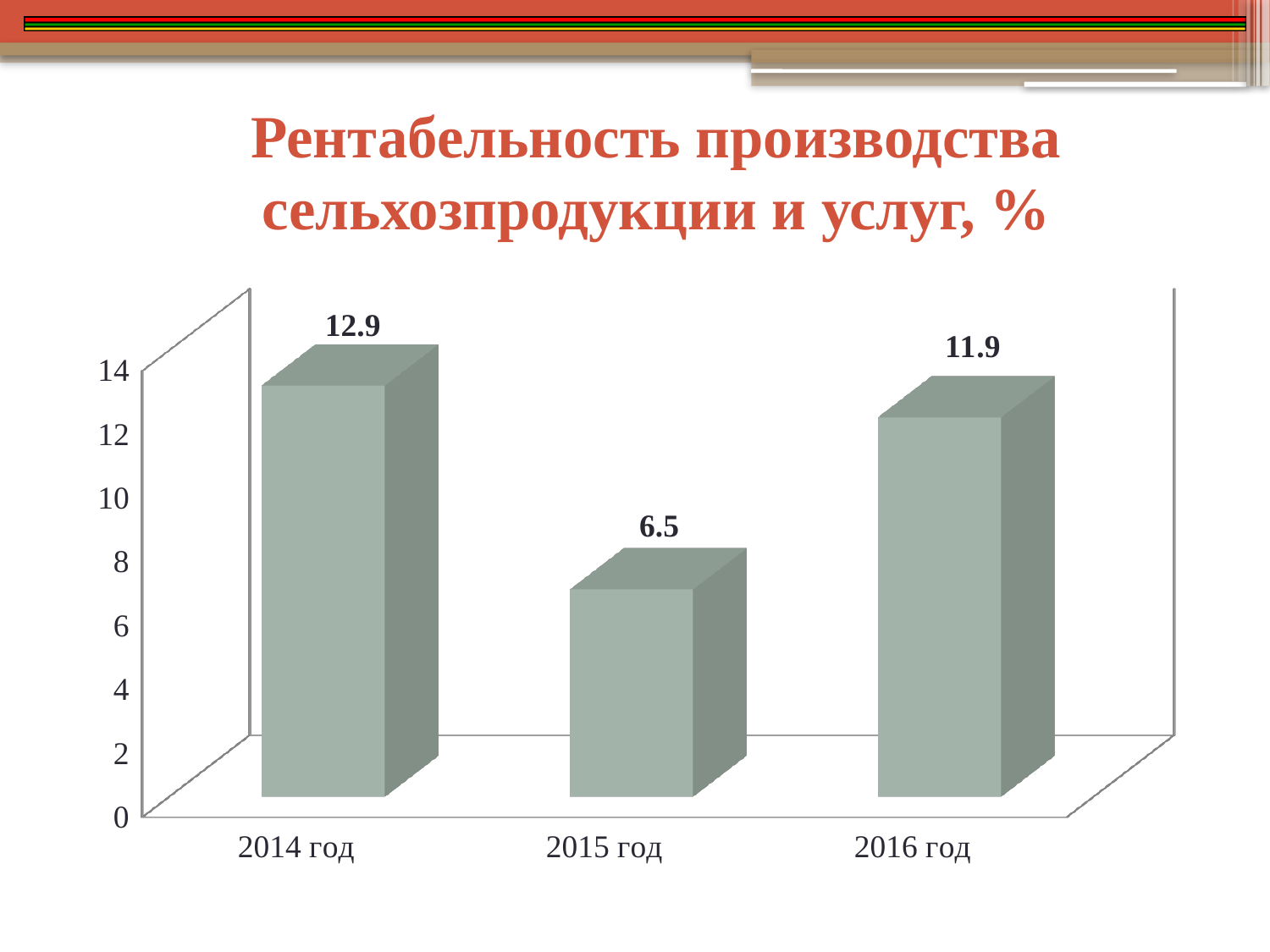
How many years are shown on the chart? 3 What is the value for 2014 год? 12.9 What is the title of the chart? Рентабельность производства сельхозпродукции и услуг, % What is the difference between the values for 2014 год and 2015 год? 6.4 Which year has the lowest value? 2015 год What is the value for 2016 год? 11.9 What is the difference between the values for 2016 год and 2015 год? 5.4 What is the value for 2015 год? 6.5 Which year has the highest value? 2014 год Which is larger, the value for 2014 год or the value for 2016 год? 2014 год Is the value for 2015 год greater or less than 8? less What kind of chart is shown on the slide? bar chart